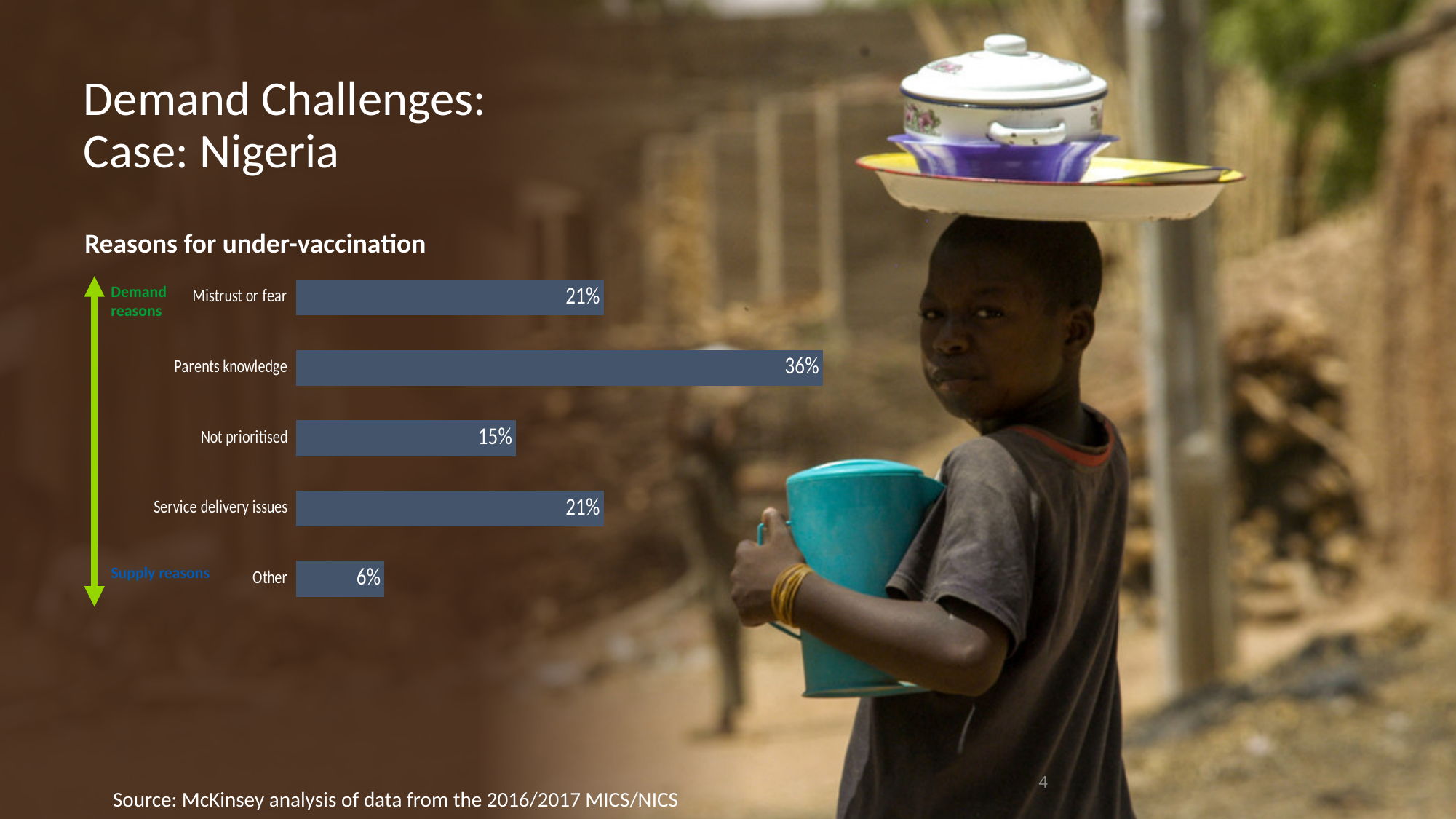
What kind of chart is used to show the reasons for under-vaccination? Bar chart What is the value for Other? 6% How many reasons for under-vaccination are plotted in the chart? 5 Which is larger, the value for Not prioritised or the value for Service delivery issues? Service delivery issues What is the difference between the values for Parents knowledge and Mistrust or fear? 15% What is the difference between the values for Not prioritised and Other? 9% What is the value for Service delivery issues? 21% What is the title of the chart? Reasons for under-vaccination Which reason for under-vaccination has the highest value? Parents knowledge What percentage is shown for Parents knowledge? 36% What is the value for Not prioritised? 15% Which reason for under-vaccination has the lowest value? Other